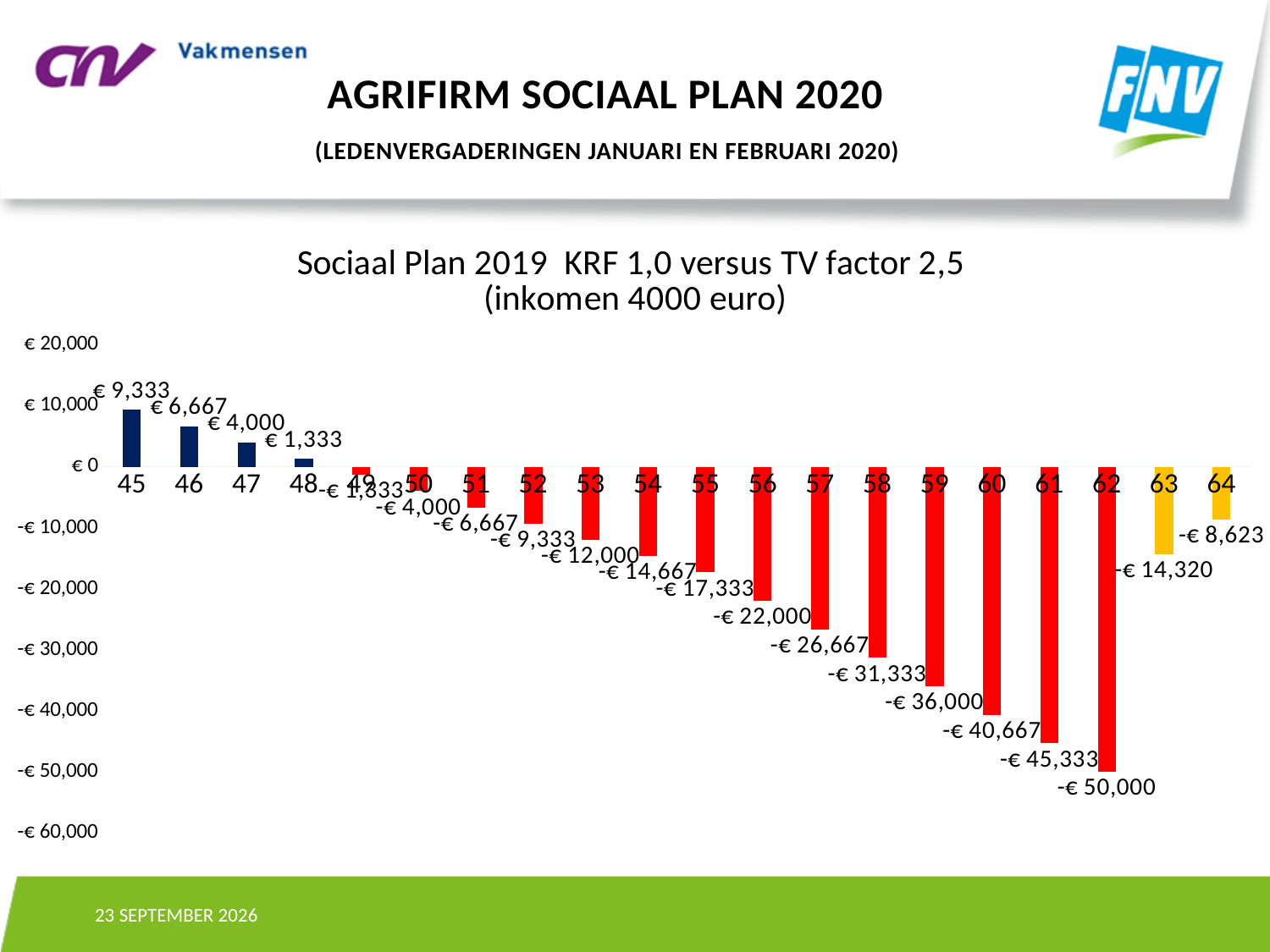
What is the chart's title? Sociaal Plan 2019 KRF 1,0 versus TV factor 2,5 (inkomen 4000 euro) Which age has the highest value? 45 Which age has the lowest value? 62 What is the value for age 64? -€ 8,623 What is the difference between the values for age 45 and age 46? € 2,666 What is the value for age 45? € 9,333 Is the value for age 59 greater or less than -€ 30,000? less What is the value for age 56? -€ 22,000 Which is larger, the value for age 58 or the value for age 63? 63 What kind of chart is shown on the slide? bar chart What is the value for age 62? -€ 50,000 How many categories (ages) are plotted on the x axis? 20